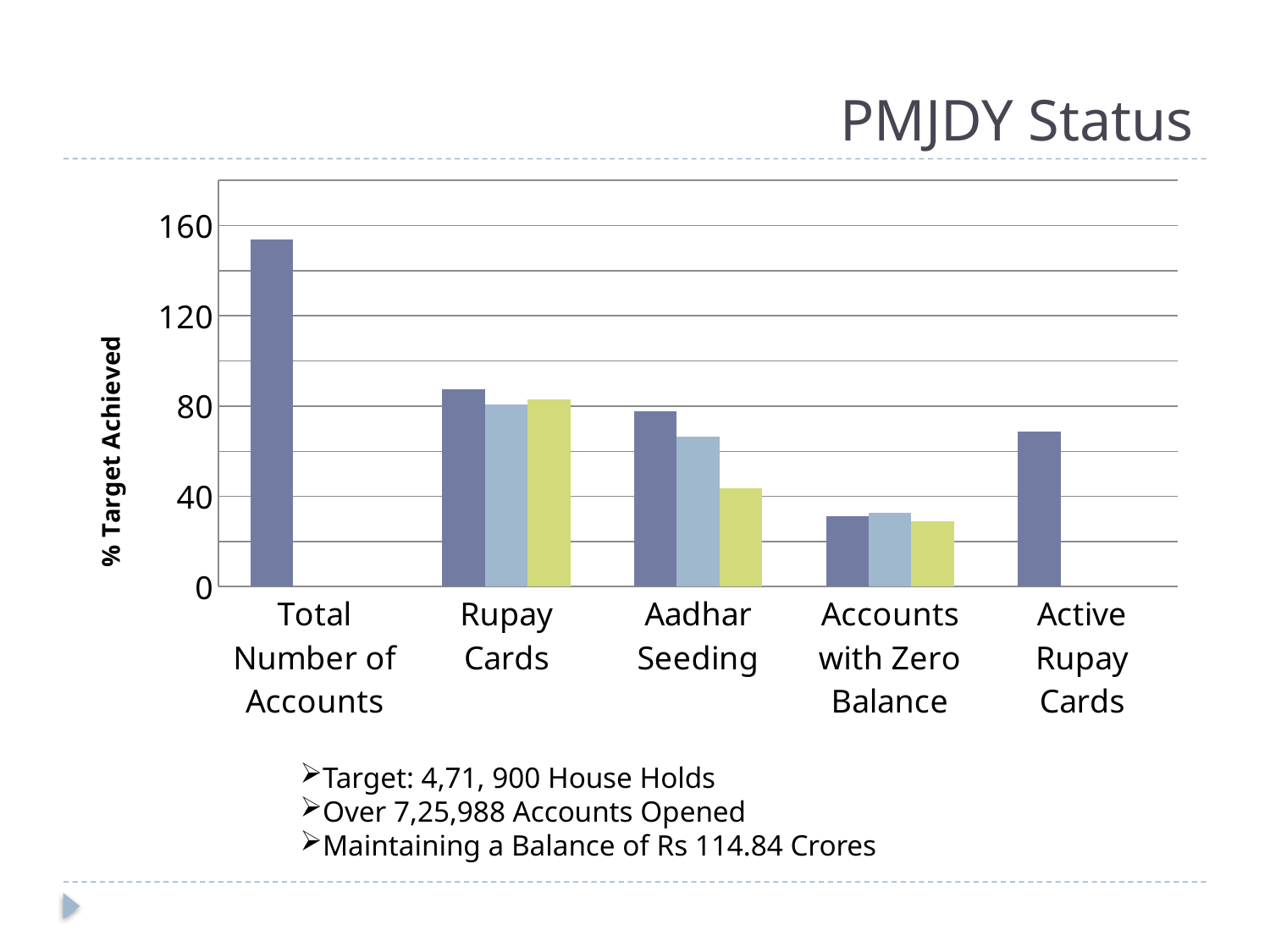
What kind of chart is shown on the slide? bar chart Is the value of the bar for Active Rupay Cards greater or less than 80? less What is the title of the slide containing the chart? PMJDY Status How many categories are shown on the x axis of the chart? 5 Which category has the lowest bars in the chart? Accounts with Zero Balance Is the value of the light blue bar for Aadhar Seeding greater or less than 80? less What is the label on the vertical axis of the chart? % Target Achieved Is the value of the dark blue bar for Accounts with Zero Balance greater or less than 40? less Which is larger: the bar for Total Number of Accounts or the bar for Active Rupay Cards? Total Number of Accounts Which category has the tallest bar in the chart? Total Number of Accounts